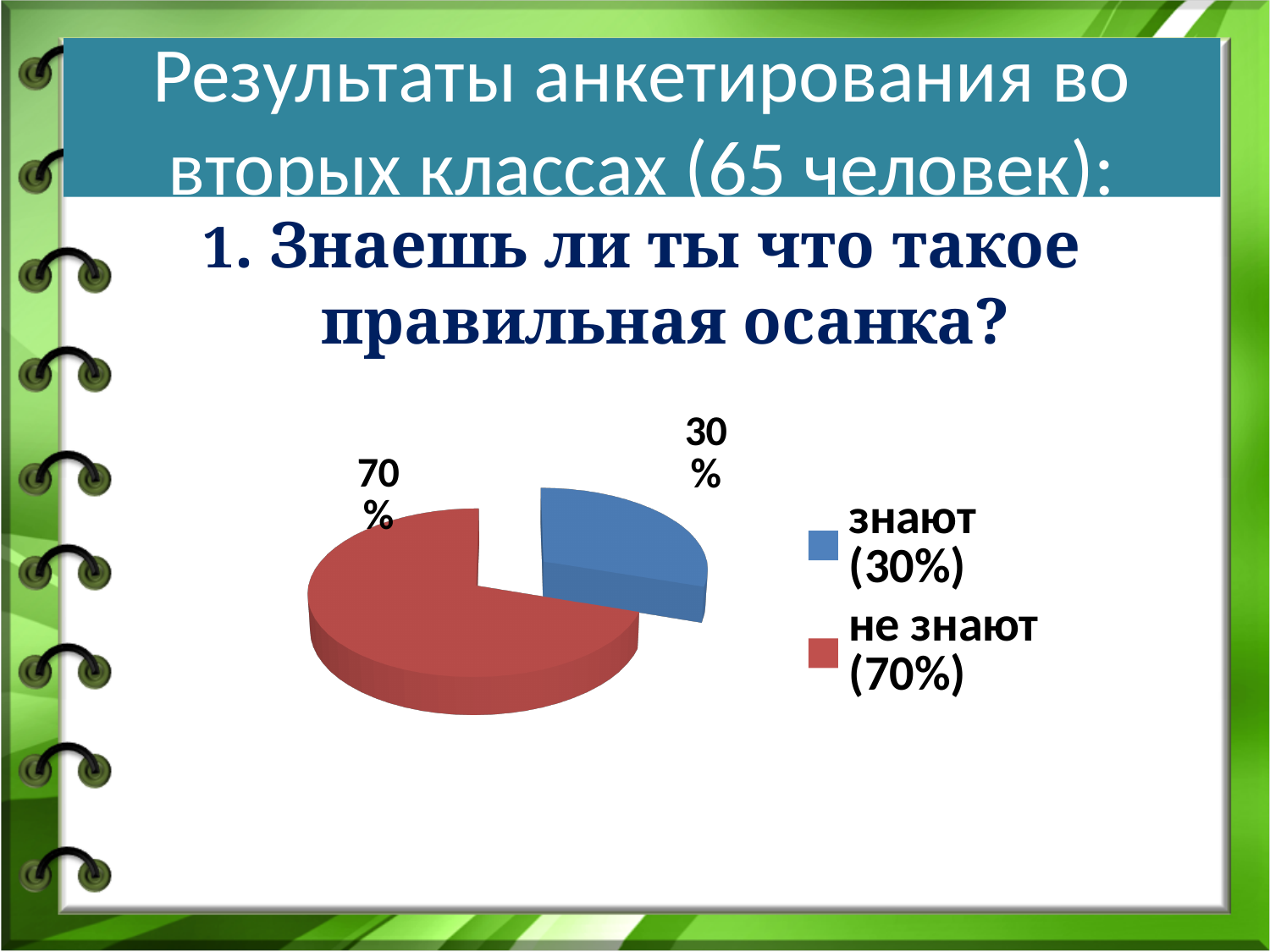
How many entries does the legend list? 2 What kind of chart is shown on the slide? pie chart What share of the pie does the "не знают" slice represent? 70% What share of the pie does the "знают" slice represent? 30% What colour is the "знают" slice? blue Is the share for "не знают" greater or less than 50%? greater Which slice is the smallest in the pie chart? знают What is the difference in percentage points between the "не знают" and "знают" slices? 40 How many slices does the pie chart have? 2 Which slice is the largest in the pie chart? не знают Which is larger: the "знают" slice or the "не знают" slice? не знают What colour is the "не знают" slice? red